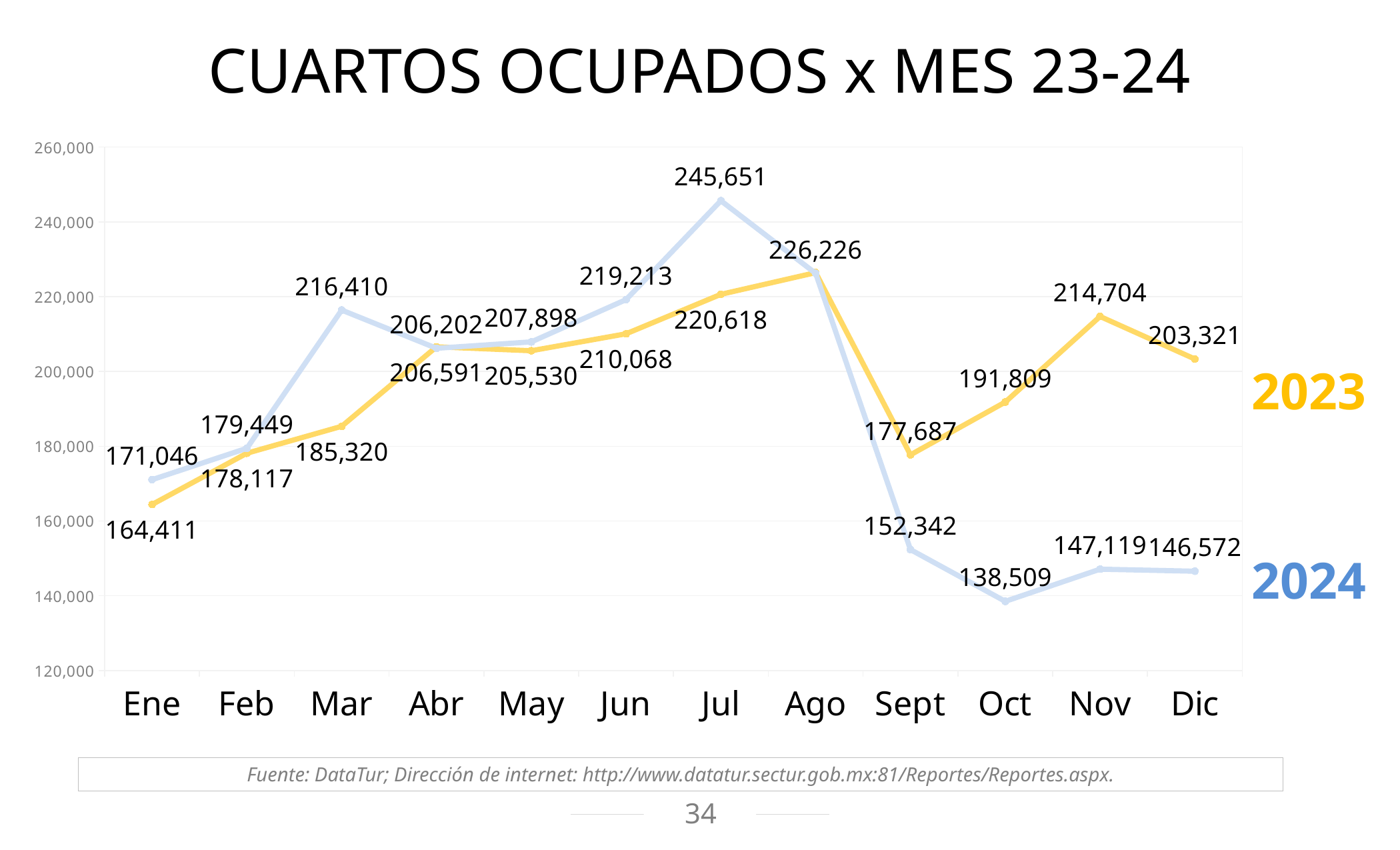
What is the value for Oct in the 2024 series? 138,509 What is the value for Nov in the 2023 series? 214,704 What kind of chart is shown on the slide? Line chart What is the value for Jul in the 2024 series? 245,651 Which month has the highest value in the 2024 series? Jul How many months are shown on the x axis? 12 Which month has the lowest value in the 2024 series? Oct Which series has the larger value for Oct, 2023 or 2024? 2023 What is the difference between the 2024 and 2023 values for Jul? 25,033 What is the value for Ene in the 2023 series? 164,411 What is the difference between the 2023 and 2024 values for Nov? 67,585 How many series does the chart show? 2